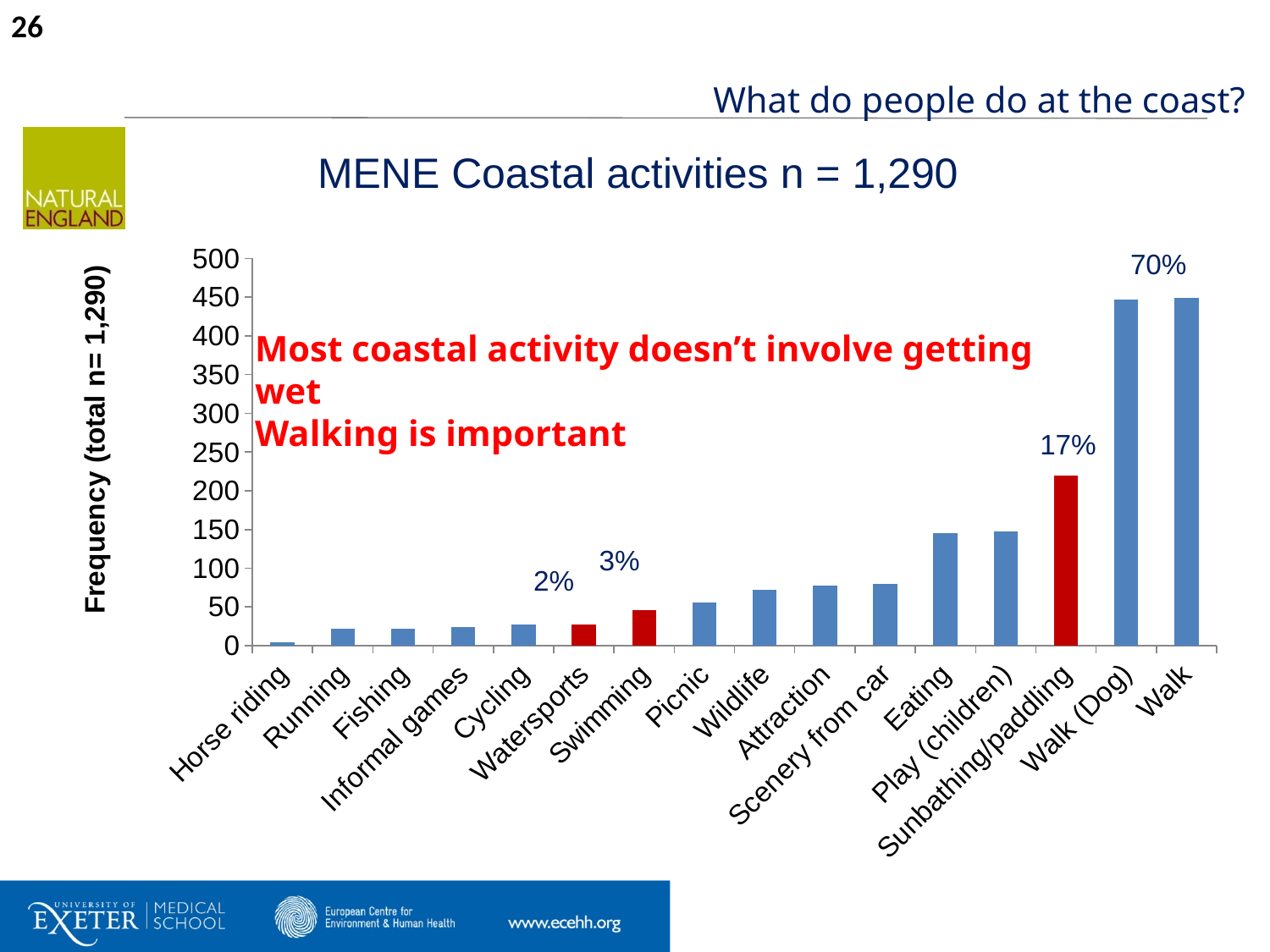
How many activity categories are plotted on the x axis? 16 What percentage label is shown above the Watersports bar? 2% What percentage label is shown above the Swimming bar? 3% Do the bar values generally rise or fall from left to right along the x axis? rise Which activity has the lowest frequency? Horse riding Is the frequency for Walk greater or less than 400? greater What kind of chart is shown on the slide? bar chart Is the frequency for Sunbathing/paddling greater or less than 200? greater What is the title of the chart? MENE Coastal activities n = 1,290 Which has the higher frequency, Sunbathing/paddling or Eating? Sunbathing/paddling What percentage label is shown above the Sunbathing/paddling bar? 17% Is the frequency for Attraction greater or less than 100? less